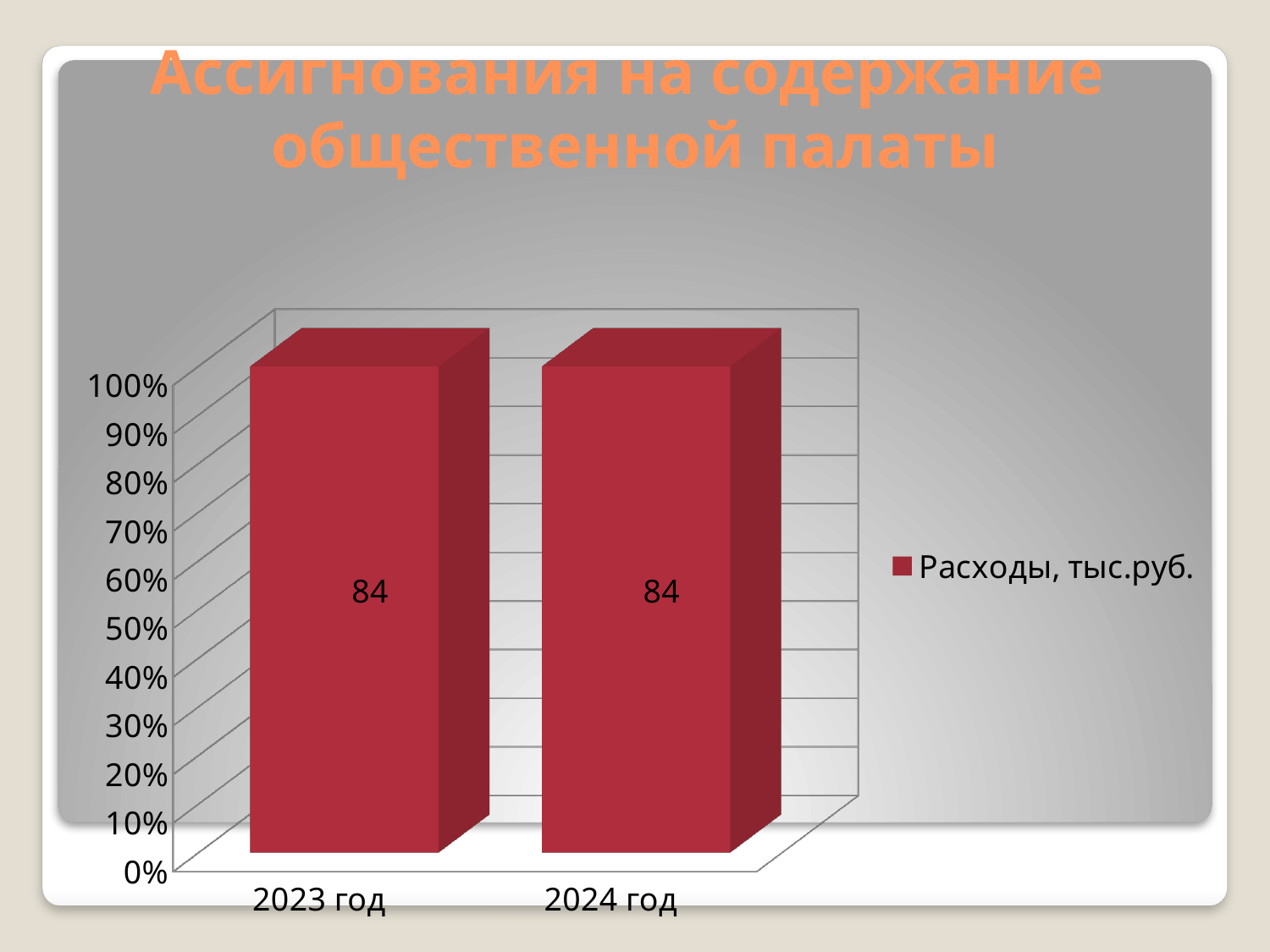
What is the value shown for 2024 год? 84 Do the values rise, fall or stay the same from 2023 год to 2024 год? stay the same What is the difference between the values for 2023 год and 2024 год? 0 How many series does the legend list? 1 What kind of chart is shown on the slide? bar chart How many categories are shown on the x axis? 2 What is the value shown for 2023 год? 84 Is the value for 2023 год equal to the value for 2024 год? yes What is the title of the chart? Ассигнования на содержание общественной палаты What series name is shown in the legend? Расходы, тыс.руб.